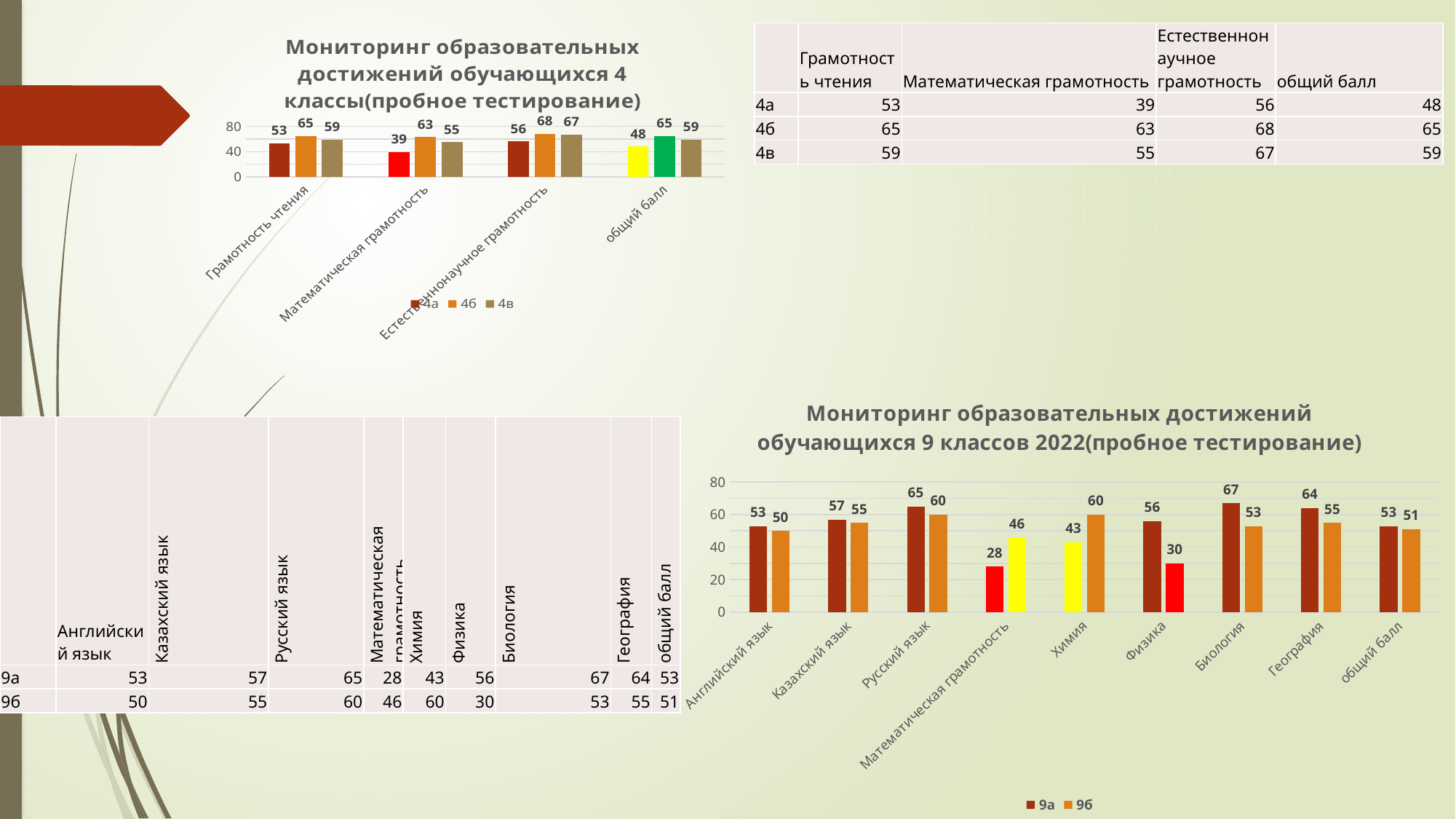
In the chart titled 'Мониторинг образовательных достижений обучающихся 9 классов 2022(пробное тестирование)', what is the difference between 9б and 9а for Математическая грамотность? 18 What kind of chart is the chart titled 'Мониторинг образовательных достижений обучающихся 9 классов 2022(пробное тестирование)'? Bar chart In the chart titled 'Мониторинг образовательных достижений обучающихся 4 классы(пробное тестирование)', what is the value for 4а in Математическая грамотность? 39 In the chart titled 'Мониторинг образовательных достижений обучающихся 9 классов 2022(пробное тестирование)', what is the value for 9б in Химия? 60 In the chart titled 'Мониторинг образовательных достижений обучающихся 9 классов 2022(пробное тестирование)', what is the value for 9а in Биология? 67 In the chart titled 'Мониторинг образовательных достижений обучающихся 4 классы(пробное тестирование)', what is the difference between 4б and 4а for общий балл? 17 In the chart titled 'Мониторинг образовательных достижений обучающихся 9 классов 2022(пробное тестирование)', which category has the lowest value for 9а? Математическая грамотность How many series does the legend list in the chart titled 'Мониторинг образовательных достижений обучающихся 4 классы(пробное тестирование)'? 3 How many categories are shown on the x axis of the chart titled 'Мониторинг образовательных достижений обучающихся 9 классов 2022(пробное тестирование)'? 9 In the chart titled 'Мониторинг образовательных достижений обучающихся 4 классы(пробное тестирование)', what is the value for 4б in Грамотность чтения? 65 In the chart titled 'Мониторинг образовательных достижений обучающихся 9 классов 2022(пробное тестирование)', which is larger for Физика: 9а or 9б? 9а In the chart titled 'Мониторинг образовательных достижений обучающихся 4 классы(пробное тестирование)', which class has the highest value for Естественнонаучное грамотность? 4б